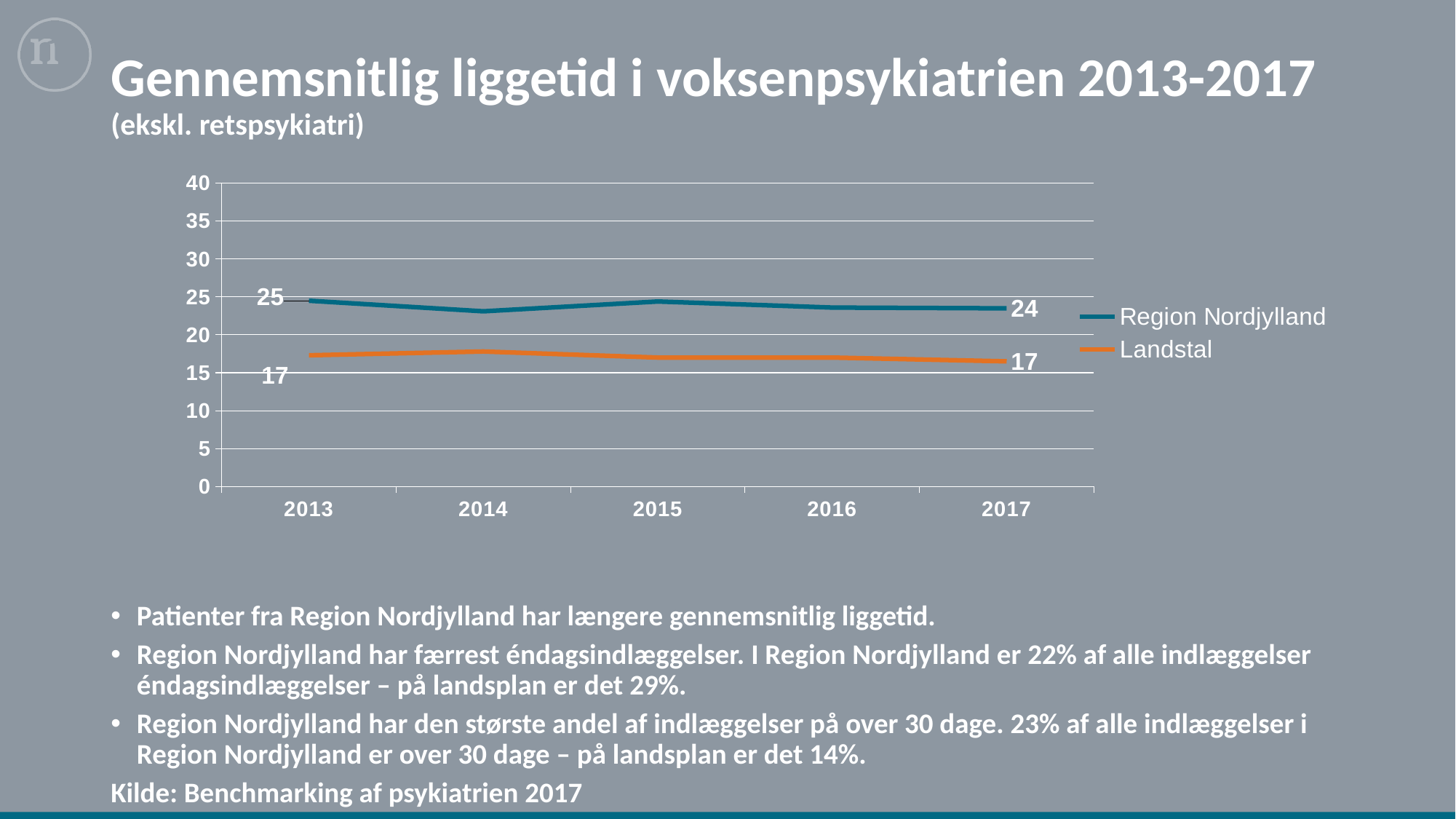
What is the difference between Region Nordjylland and Landstal in 2013? 8 What is the value for Landstal in 2017? 17 What is the value for Region Nordjylland in 2013? 25 How many series does the legend list? 2 What kind of chart is shown on the slide? line chart Which series has the higher value in 2015, Region Nordjylland or Landstal? Region Nordjylland What is the value for Region Nordjylland in 2017? 24 What is the value for Landstal in 2013? 17 How many years are shown on the x axis? 5 What is the difference between Region Nordjylland and Landstal in 2017? 7 Which series is drawn in orange? Landstal Is the value for Landstal in 2015 greater or less than 20? less